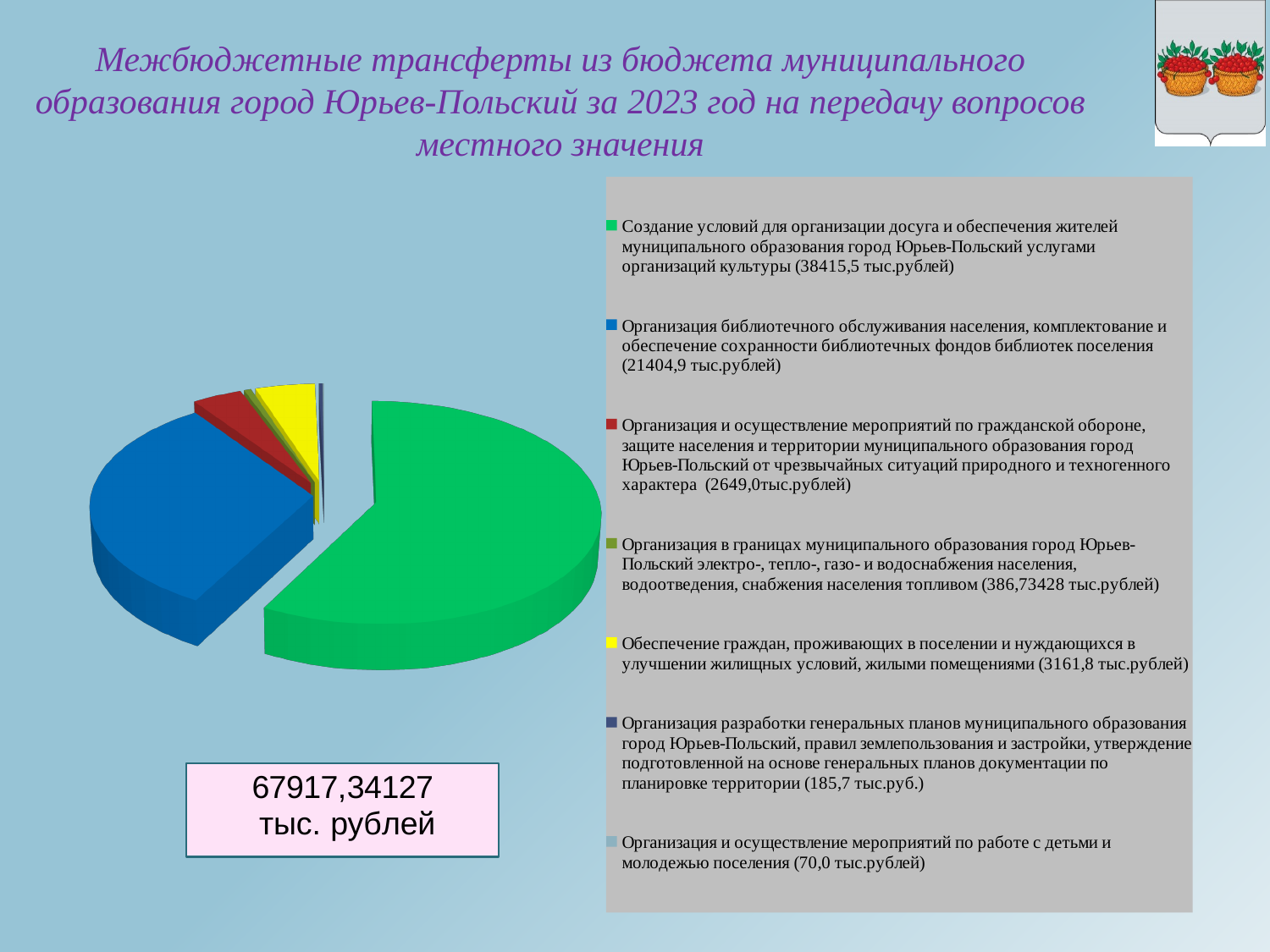
What kind of chart is shown on the slide? pie chart What is the value for 'Создание условий для организации досуга и обеспечения жителей ... услугами организаций культуры'? 38415,5 тыс.рублей What is the value for 'Организация и осуществление мероприятий по работе с детьми и молодежью поселения'? 70,0 тыс.рублей What is the value for 'Организация библиотечного обслуживания населения, комплектование и обеспечение сохранности библиотечных фондов библиотек поселения'? 21404,9 тыс.рублей What is the value for 'Организация и осуществление мероприятий по гражданской обороне ...'? 2649,0 тыс.рублей Which category has the largest share of the pie? Создание условий для организации досуга и обеспечения жителей муниципального образования город Юрьев-Польский услугами организаций культуры Which is larger: the value for civil defence measures or the value for providing citizens with housing? providing citizens with housing (3161,8 тыс.рублей) What is the value for 'Обеспечение граждан, проживающих в поселении и нуждающихся в улучшении жилищных условий, жилыми помещениями'? 3161,8 тыс.рублей Which category has the smallest value? Организация и осуществление мероприятий по работе с детьми и молодежью поселения What total amount is shown in the box below the pie chart? 67917,34127 тыс. рублей How many categories does the legend of the pie chart list? 7 What is the difference between the value for culture services (38415,5) and library services (21404,9)? 17010,6 тыс.рублей